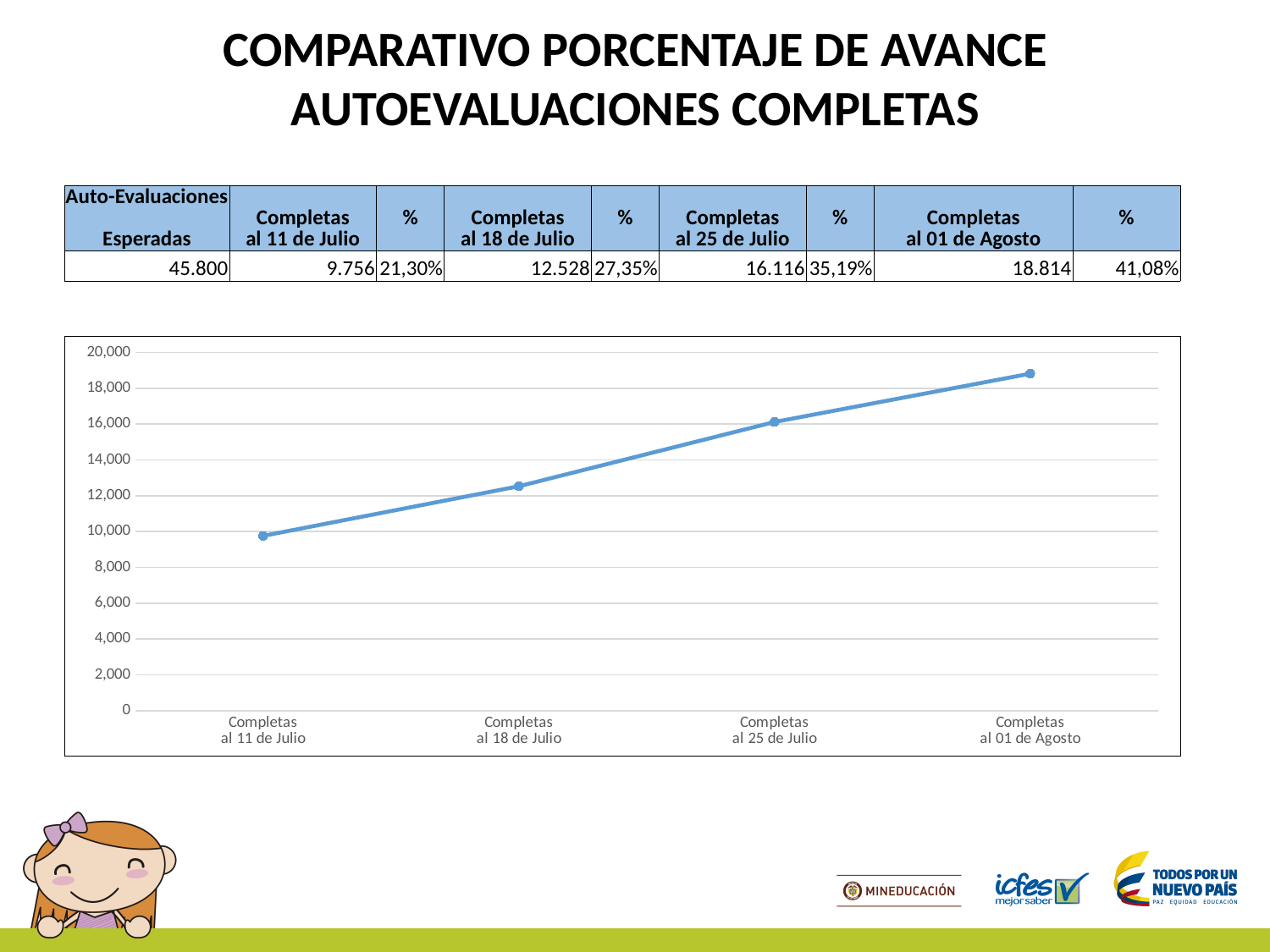
Is the value for Completas al 25 de Julio greater or less than 16,000? greater Which category has the lowest value on the line chart? Completas al 11 de Julio Which category has the highest value on the line chart? Completas al 01 de Agosto Is the value for Completas al 18 de Julio greater or less than 12,000? greater Is the value for Completas al 11 de Julio greater or less than 10,000? less What is the highest value shown on the chart's vertical axis? 20,000 How many data points are plotted on the line chart? 4 Do the values on the line chart rise or fall from left to right along the x axis? rise According to the slide, what is the value of Completas al 01 de Agosto plotted on the chart? 18.814 What kind of chart is shown on the slide? line chart Which is larger on the line chart, the value for Completas al 18 de Julio or the value for Completas al 25 de Julio? Completas al 25 de Julio